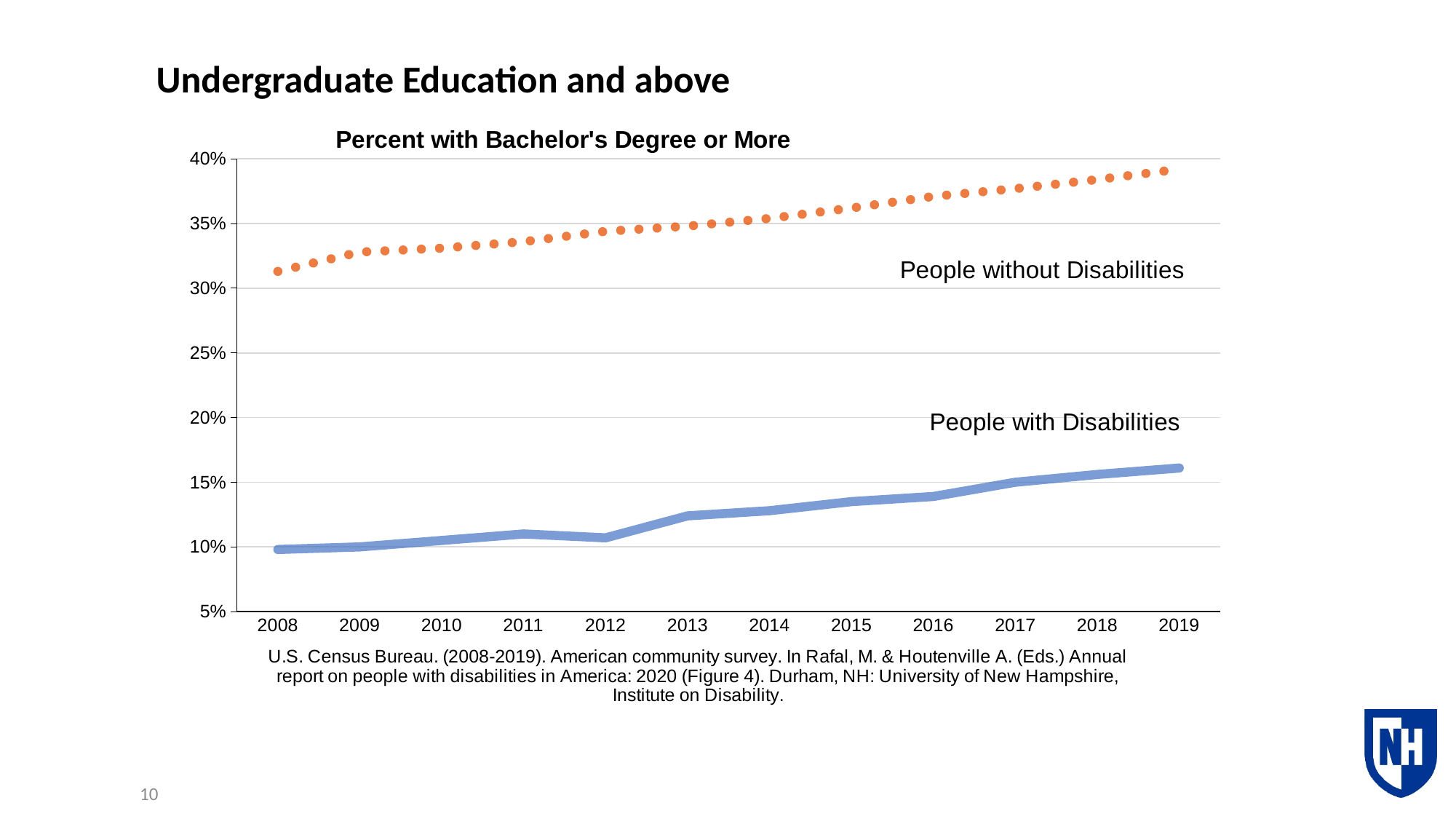
In which year is the value for People with Disabilities highest? 2019 Which series is drawn as an orange dotted line? People without Disabilities In which year is the value for People without Disabilities lowest? 2008 Does the value for People without Disabilities rise or fall from 2008 to 2019? rise How many years are shown along the x axis? 12 What kind of chart is shown on the slide? line chart How many series are plotted on the chart? 2 Does the value for People with Disabilities rise or fall from 2008 to 2019? rise Is the value for People with Disabilities in 2019 greater or less than 15%? greater In 2015, which series has the larger value, People with Disabilities or People without Disabilities? People without Disabilities Is the value for People without Disabilities in 2010 greater or less than 35%? less What is the title of the chart? Percent with Bachelor's Degree or More